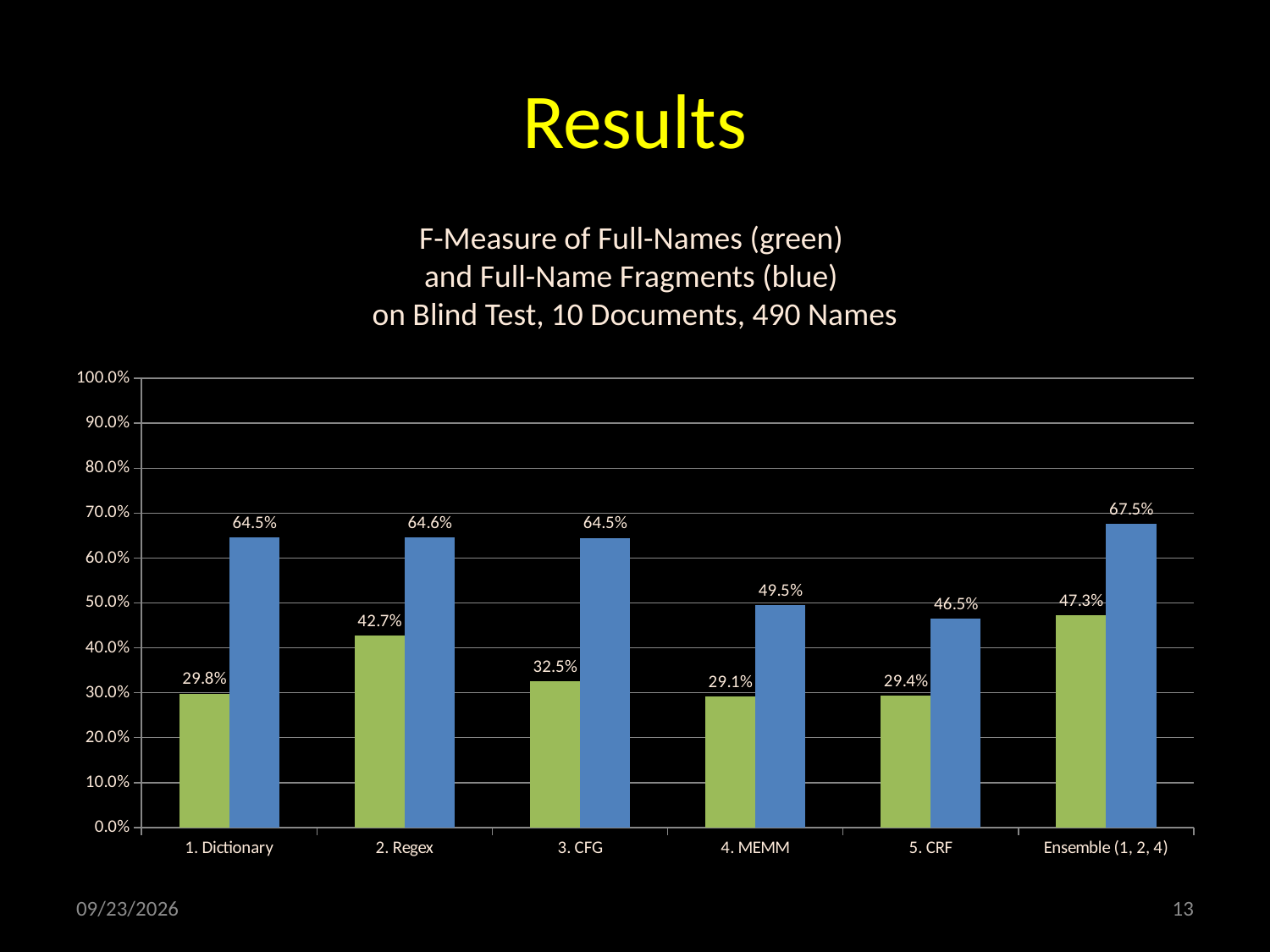
What is the green (Full-Names) value for Ensemble (1, 2, 4)? 47.3% Which category has the lowest green (Full-Names) value? 4. MEMM What is the F-Measure of Full-Name Fragments (blue) for 4. MEMM? 49.5% Which category has the lowest blue (Full-Name Fragments) value? 5. CRF Is the blue value for 5. CRF greater or less than 50.0%? less Which is larger, the green value for 2. Regex or the green value for 3. CFG? 2. Regex What is the F-Measure of Full-Names (green) for 2. Regex? 42.7% What kind of chart is shown on the slide? bar chart What is the difference between the blue and green values for 1. Dictionary? 34.7 percentage points Which category has the highest blue (Full-Name Fragments) value? Ensemble (1, 2, 4) According to the chart title, which colour represents Full-Name Fragments? blue How many categories are shown on the x axis? 6